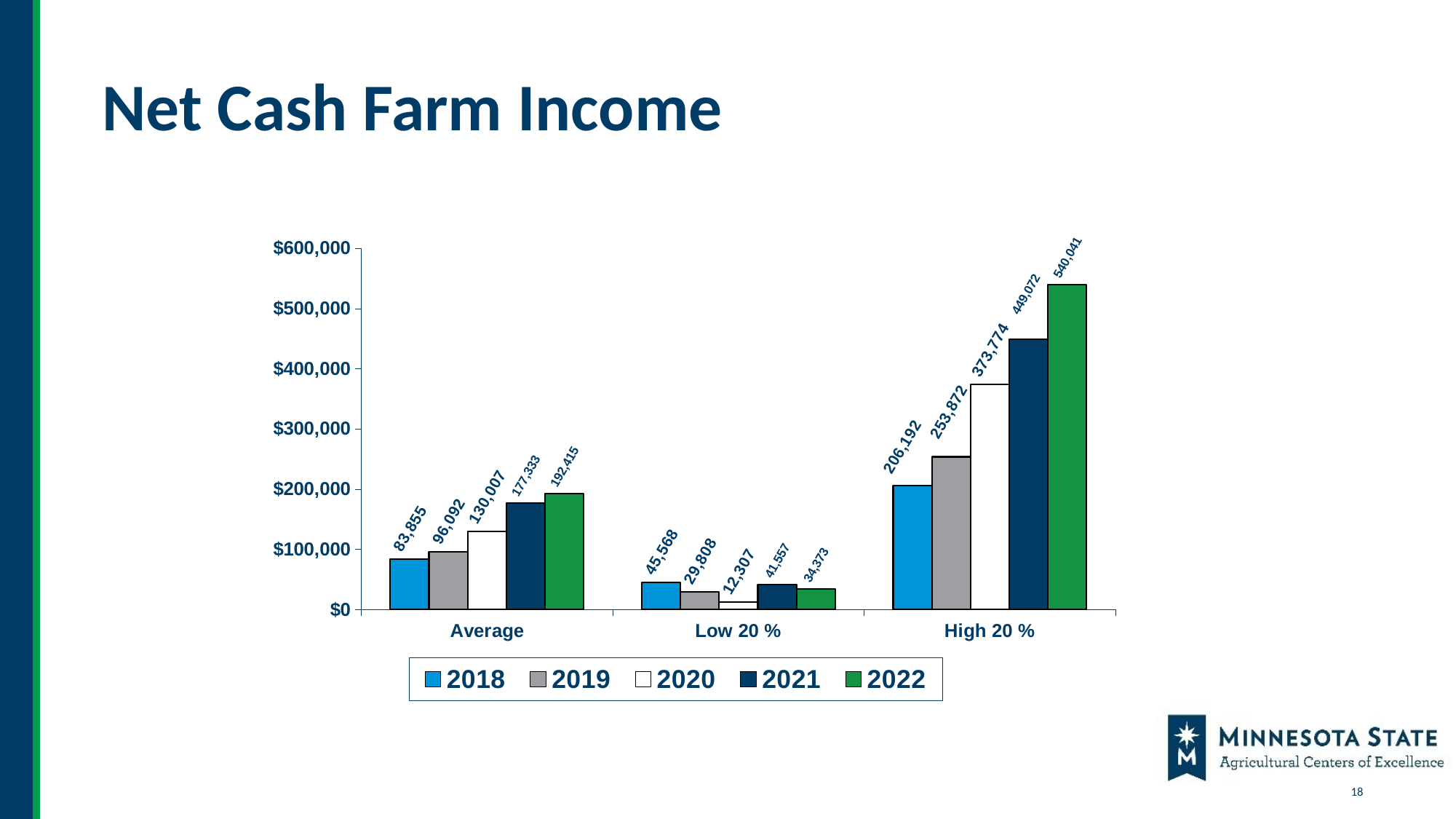
What is the Net Cash Farm Income for the High 20 % group in 2018? 206,192 What is the Net Cash Farm Income for the Low 20 % group in 2020? 12,307 Is the 2021 value for the High 20 % group greater or less than $400,000? greater Which is larger for the Low 20 % group: the 2018 value or the 2021 value? 2018 What kind of chart is shown on the slide? bar chart Which year has the highest Net Cash Farm Income for the High 20 % group? 2022 How many series does the legend list? 5 Do the Average group's values rise or fall from 2018 to 2022? rise How many categories are shown on the x axis? 3 What is the Net Cash Farm Income for the Average group in 2022? 192,415 What is the difference between the 2022 and 2021 Net Cash Farm Income for the High 20 % group? 90,969 Which year has the lowest Net Cash Farm Income for the Low 20 % group? 2020